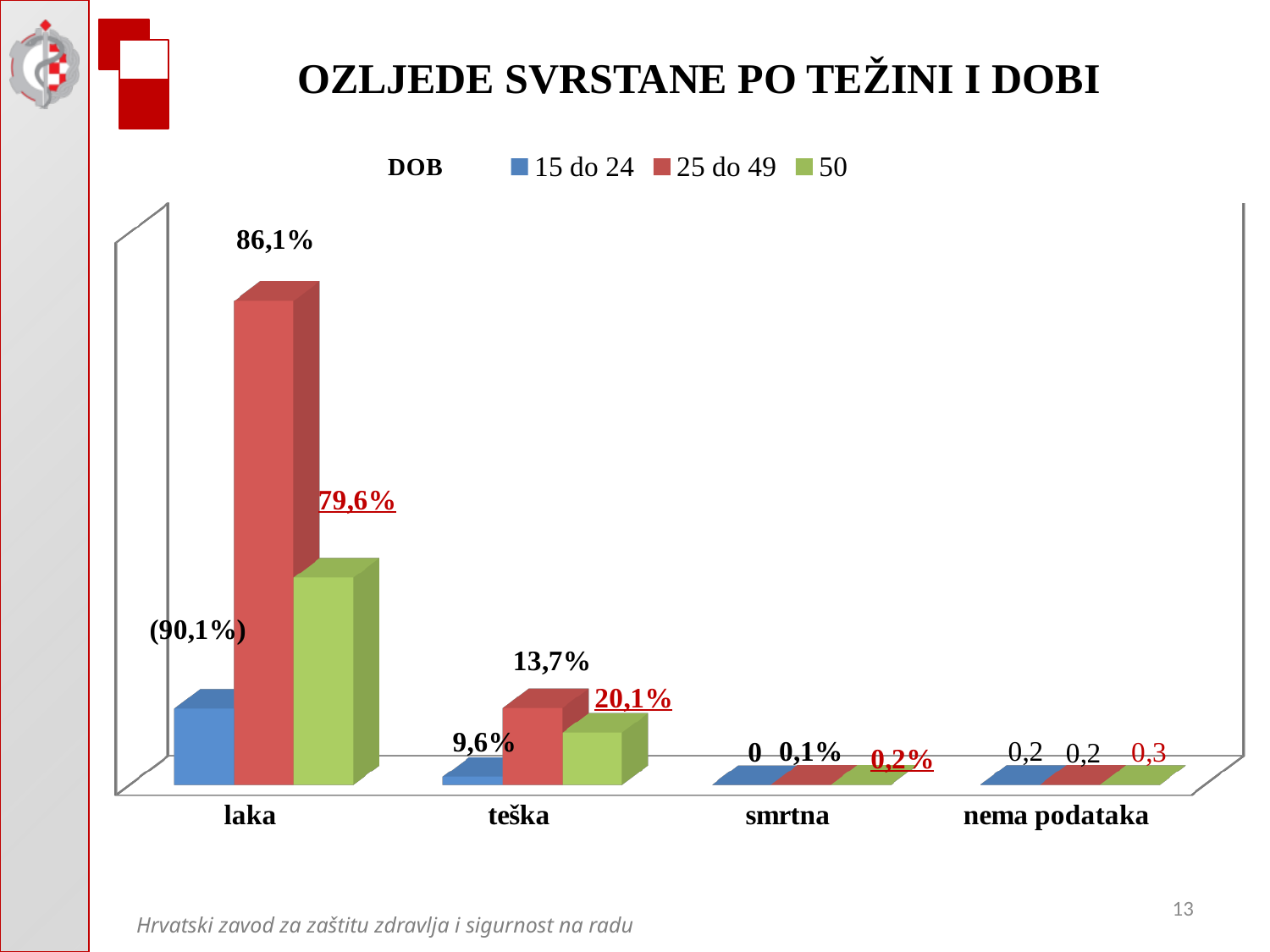
What is the value for the 15 do 24 series in the teška category? 9,6% What is the value for the 25 do 49 series in the smrtna category? 0,1% In which category is the 25 do 49 series highest? laka What type of chart is shown on the slide? bar chart What is the value for the 50 series in the teška category? 20,1% How many categories are shown on the x axis? 4 What is the value for the 25 do 49 series in the laka category? 86,1% What is the difference between the 25 do 49 and 50 values in the laka category? 6,5% How many series does the legend list? 3 What is the value for the 50 series in the nema podataka category? 0,3 What is the value for the 50 series in the laka category? 79,6%